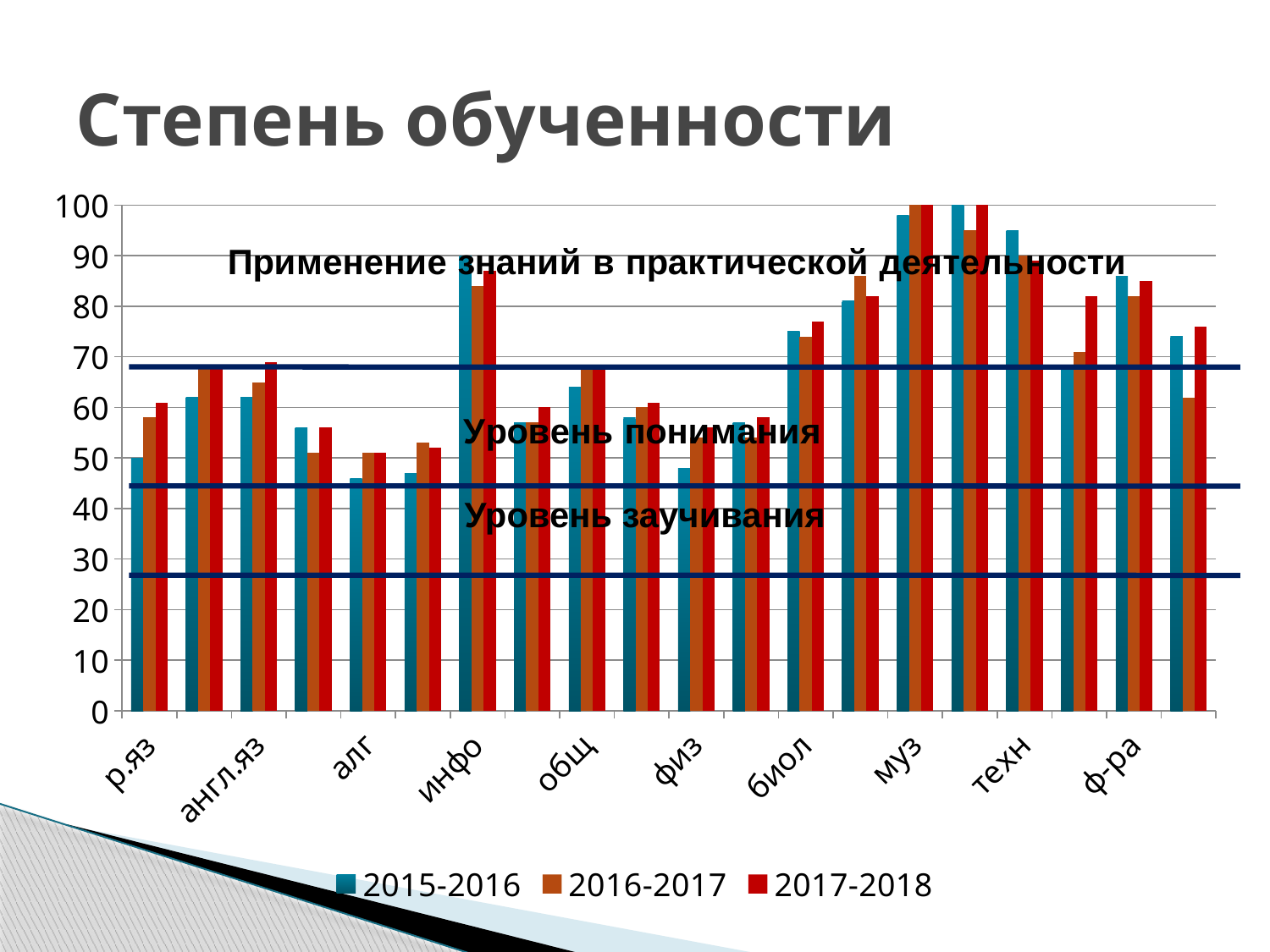
Is the 2015-2016 value for физ greater or less than 50? less Is the 2015-2016 value for алг greater or less than 50? less Which series is shown in red in the legend? 2017-2018 How many series does the legend list? 3 Is the 2017-2018 value for ф-ра greater or less than 70? greater For the 2015-2016 series, which is larger: инфо or биол? инфо What is the title of the chart? Степень обученности For the 2017-2018 series, which is larger: муз or ф-ра? муз What kind of chart is shown on the slide? bar chart